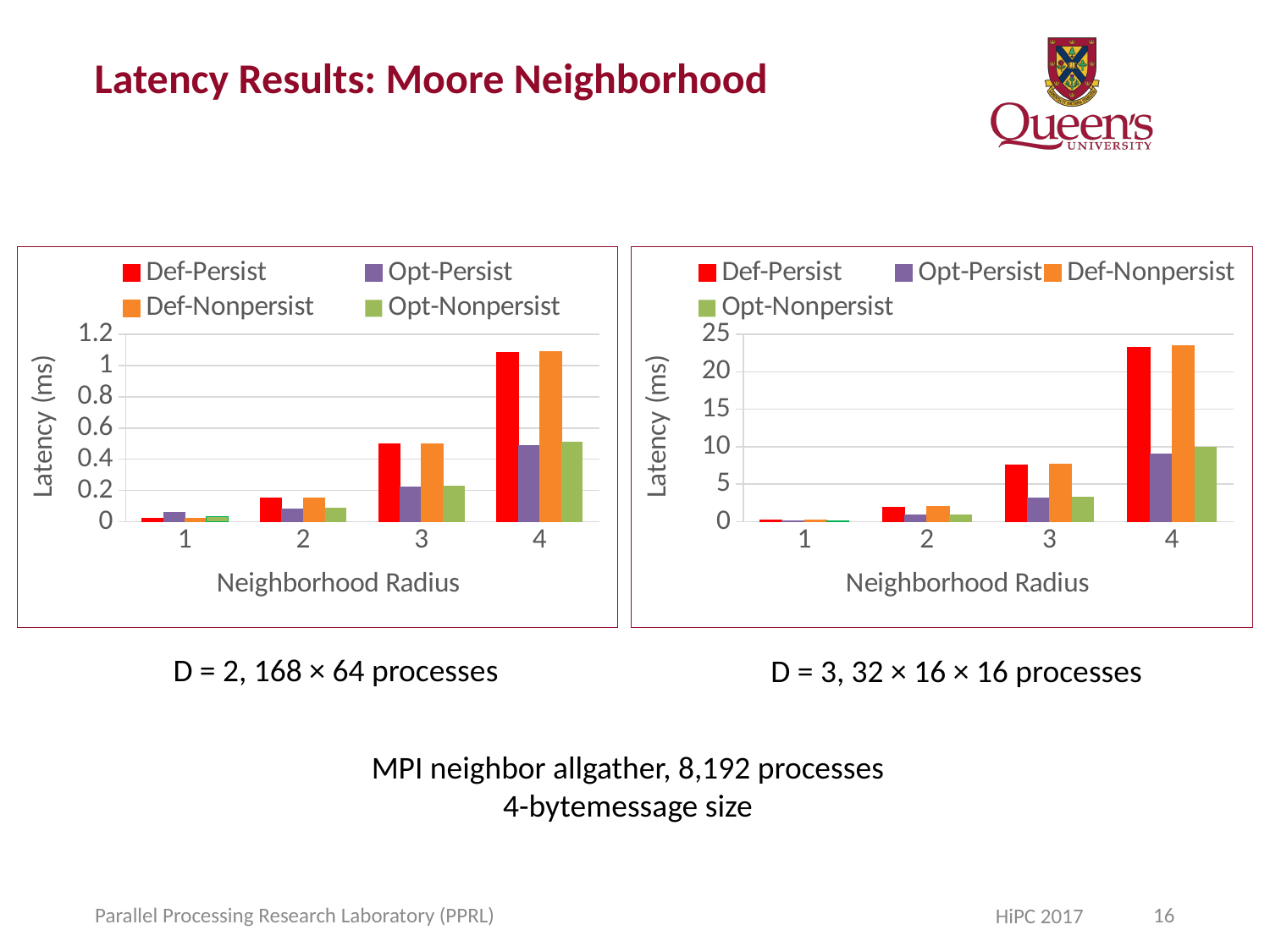
In the left chart (D = 2), what kind of chart is shown? bar chart In the right chart (D = 3), is the Def-Persist latency at neighborhood radius 4 greater or less than 20? greater In the right chart (D = 3), at neighborhood radius 4, which is larger: Def-Persist or Opt-Persist? Def-Persist In the right chart (D = 3), is the Opt-Persist latency at neighborhood radius 3 greater or less than 5? less In the left chart (D = 2), is the Opt-Persist latency at neighborhood radius 4 greater or less than 0.6? less In the right chart (D = 3), how many series does the legend list? 4 In the right chart (D = 3), which neighborhood radius has the lowest latency values? 1 In the left chart (D = 2), do the latency values rise or fall as the neighborhood radius increases? rise In the left chart (D = 2), which neighborhood radius has the highest latency values? 4 In the left chart (D = 2), how many neighborhood radius categories are shown on the x axis? 4